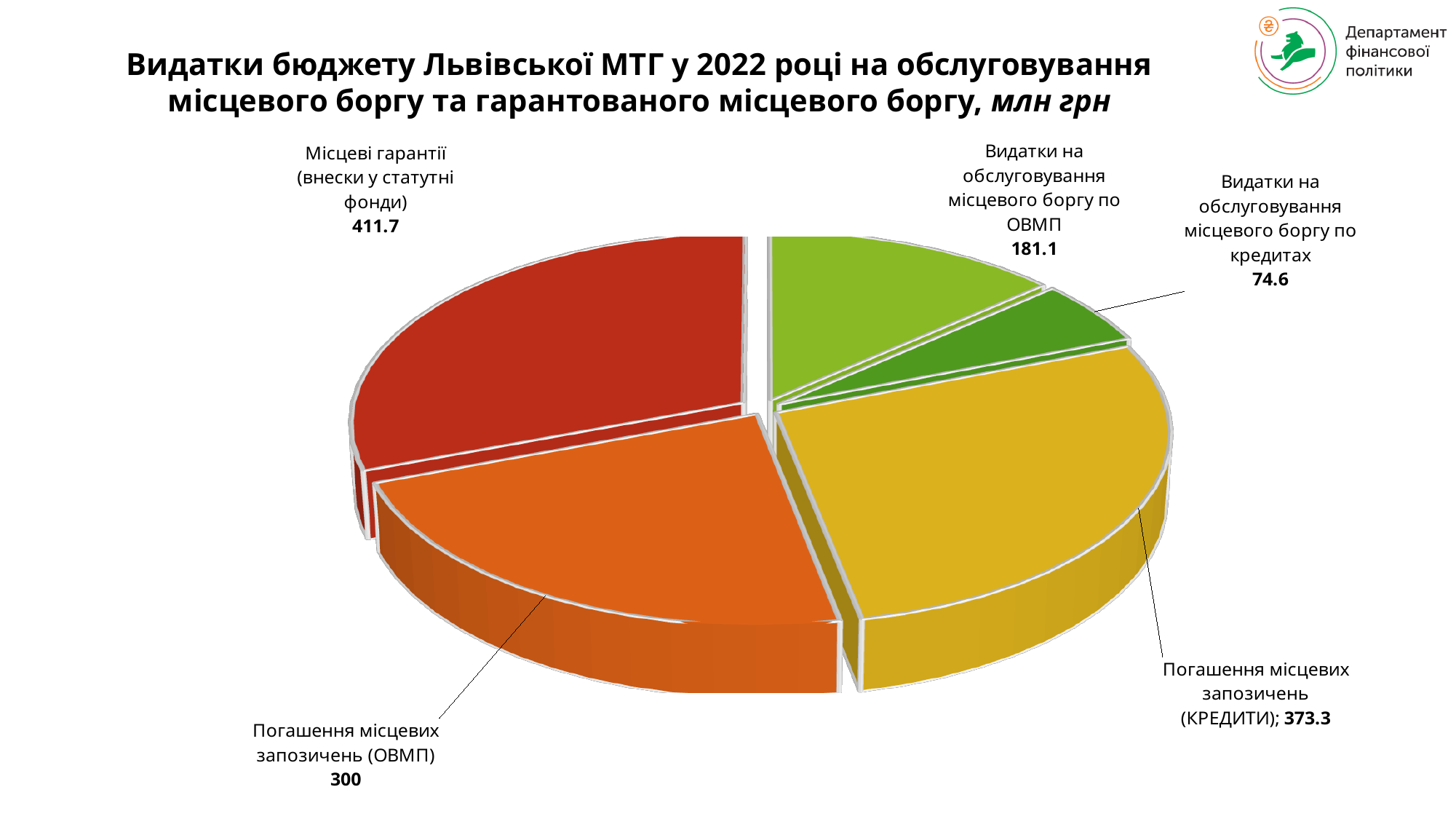
What is the value for Видатки на обслуговування місцевого боргу по ОВМП? 181.1 Which category has the smallest value? Видатки на обслуговування місцевого боргу по кредитах What is the value for Погашення місцевих запозичень (КРЕДИТИ)? 373.3 What is the difference between Місцеві гарантії (внески у статутні фонди) and Погашення місцевих запозичень (КРЕДИТИ)? 38.4 How many slices does the pie chart have? 5 Which is larger: Погашення місцевих запозичень (КРЕДИТИ) or Погашення місцевих запозичень (ОВМП)? Погашення місцевих запозичень (КРЕДИТИ) What is the total of all slices in the pie chart? 1340.7 What is the value for Місцеві гарантії (внески у статутні фонди)? 411.7 Which category has the largest value? Місцеві гарантії (внески у статутні фонди) What is the value for Погашення місцевих запозичень (ОВМП)? 300 What type of chart is shown on the slide? Pie chart What is the value for Видатки на обслуговування місцевого боргу по кредитах? 74.6